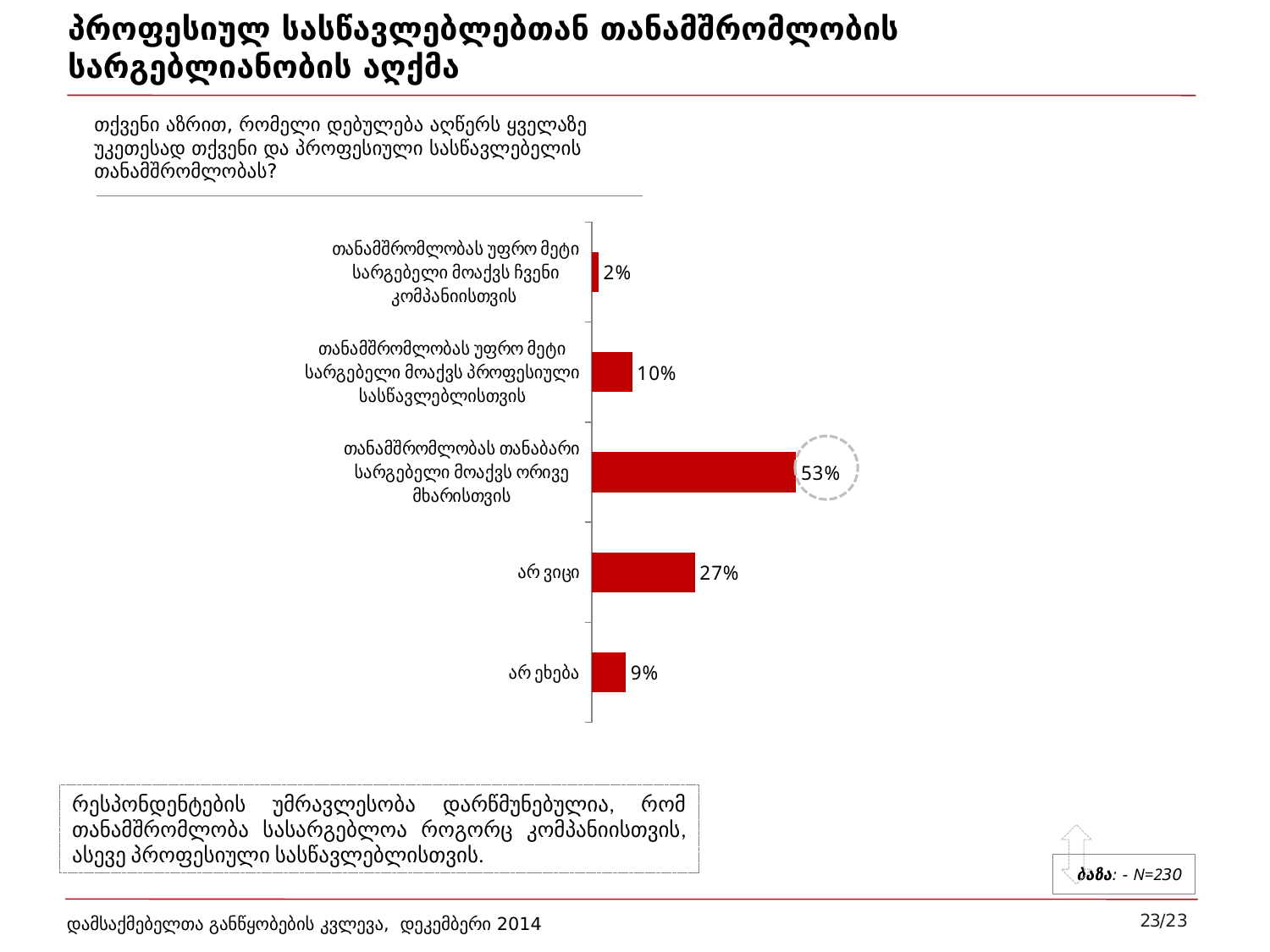
How many categories are shown in the chart? 5 What is the difference between the value for "თანამშრომლობას უფრო მეტი სარგებელი მოაქვს პროფესიული სასწავლებლისთვის" and the value for "თანამშრომლობას უფრო მეტი სარგებელი მოაქვს ჩვენი კომპანიისთვის"? 8% What percentage of respondents answered "არ ვიცი"? 27% Which is larger: the value for "თანამშრომლობას უფრო მეტი სარგებელი მოაქვს პროფესიული სასწავლებლისთვის" or the value for "არ ეხება"? თანამშრომლობას უფრო მეტი სარგებელი მოაქვს პროფესიული სასწავლებლისთვის What is the value for "თანამშრომლობას უფრო მეტი სარგებელი მოაქვს ჩვენი კომპანიისთვის"? 2% What is the value for "არ ეხება"? 9% What is the difference between the value for "თანამშრომლობას თანაბარი სარგებელი მოაქვს ორივე მხარისთვის" and the value for "არ ვიცი"? 26% What kind of chart is shown on the slide? Bar chart Which category has the lowest value? თანამშრომლობას უფრო მეტი სარგებელი მოაქვს ჩვენი კომპანიისთვის Which category has the highest value? თანამშრომლობას თანაბარი სარგებელი მოაქვს ორივე მხარისთვის What is the value for "თანამშრომლობას თანაბარი სარგებელი მოაქვს ორივე მხარისთვის"? 53% What sample size (N) is stated on the slide? N=230